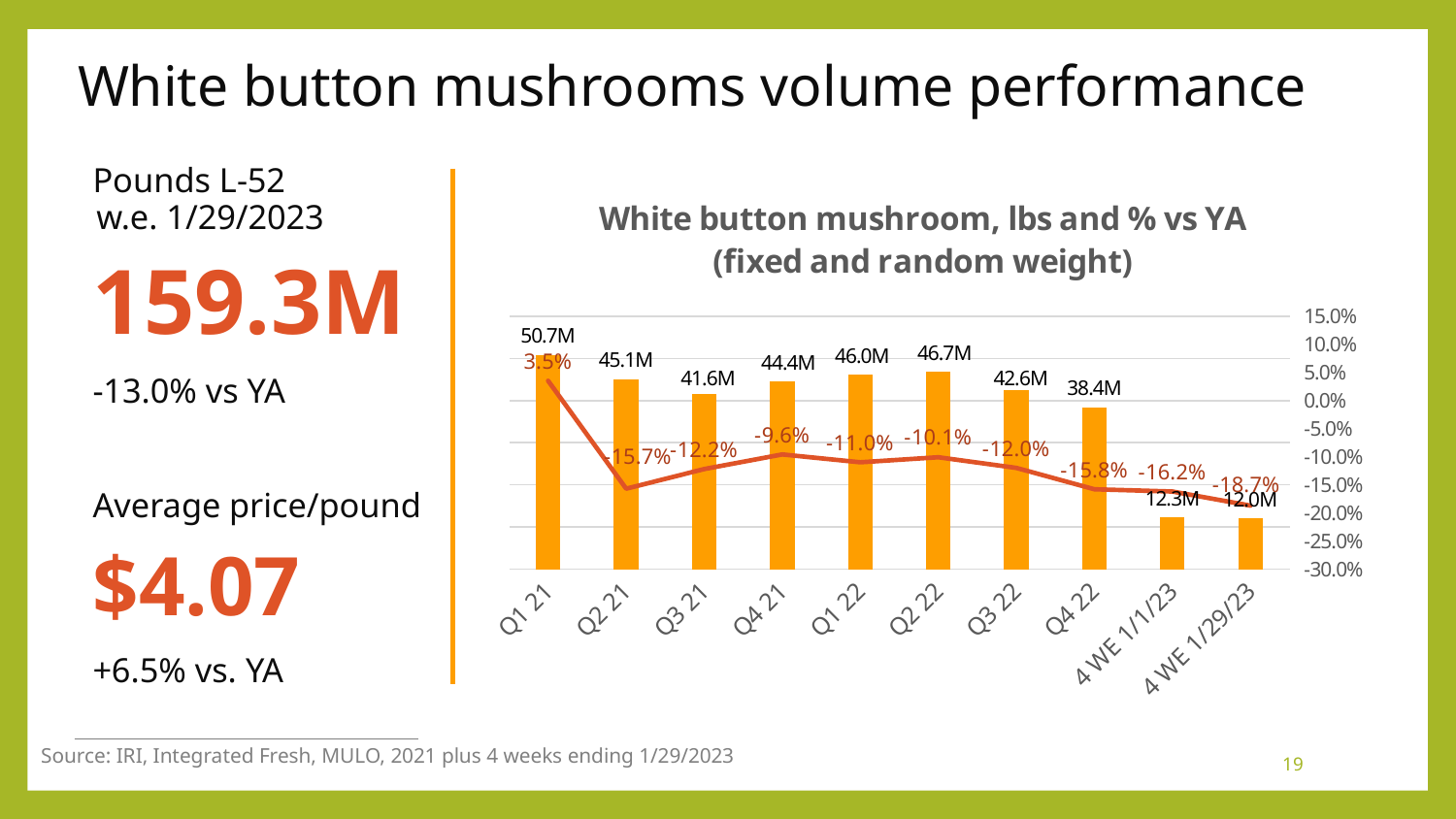
What is the title of the chart? White button mushroom, lbs and % vs YA (fixed and random weight) What is the volume in pounds for Q1 21? 50.7M Which has a higher volume in pounds, Q3 21 or Q1 22? Q1 22 What is the difference in pounds between Q2 22 and Q4 22? 8.3M What is the % vs YA value for Q4 21? -9.6% What is the % vs YA value for Q2 21? -15.7% Which category has the highest volume in pounds? Q1 21 How many categories are shown on the x axis? 10 What kind of chart is this? Combined bar and line chart Does the % vs YA line generally rise or fall from Q4 21 to 4 WE 1/29/23? Fall Which category has the lowest % vs YA value? 4 WE 1/29/23 What is the volume in pounds for 4 WE 1/29/23? 12.0M